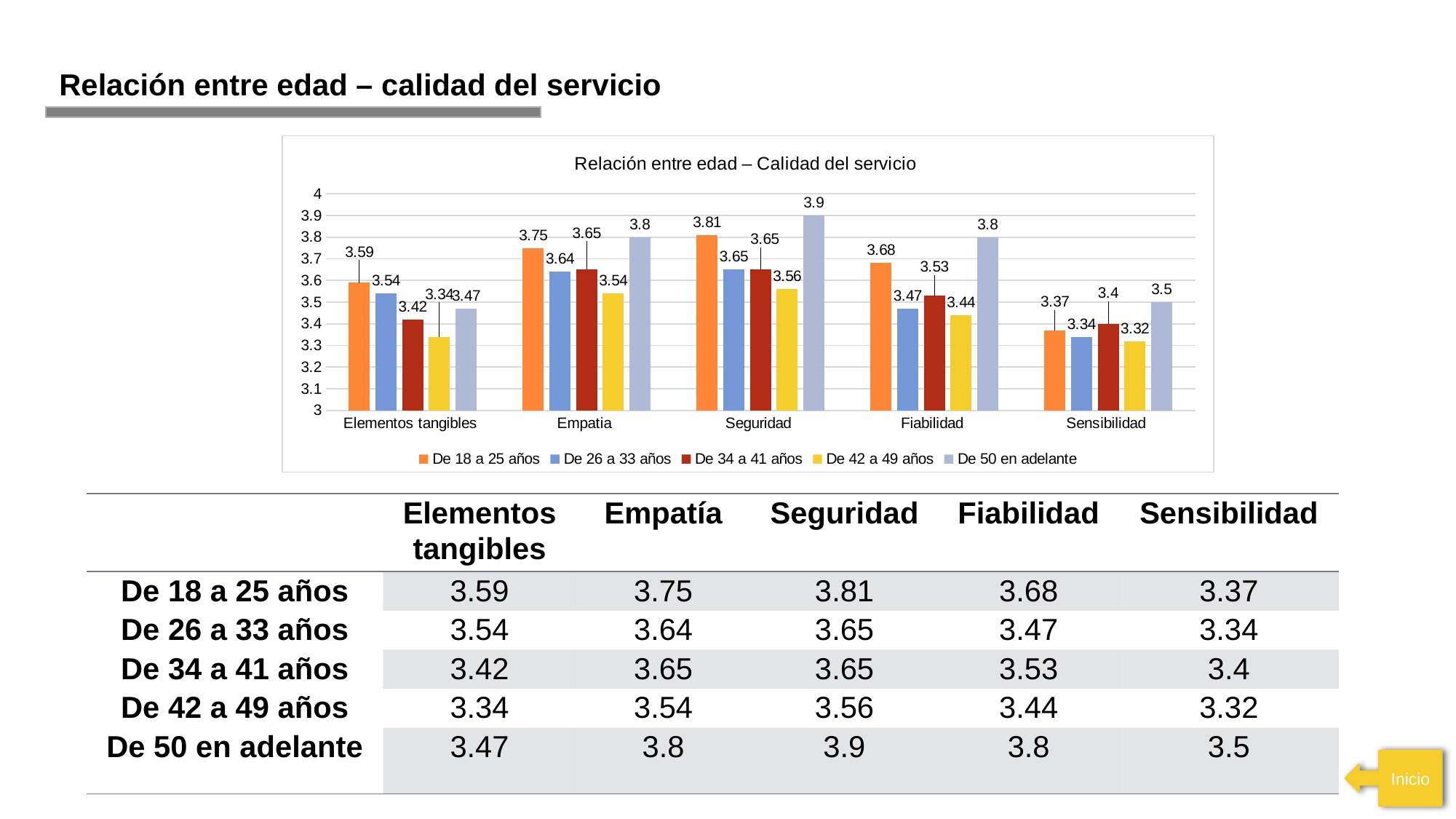
What is the value for 'De 18 a 25 años' in the Seguridad category? 3.81 What kind of chart is shown on the slide? Bar chart What is the title of the chart? Relación entre edad – Calidad del servicio Which category has the highest value for the 'De 50 en adelante' series? Seguridad What is the value for 'De 42 a 49 años' in the Sensibilidad category? 3.32 In the Elementos tangibles category, which is larger: 'De 18 a 25 años' or 'De 26 a 33 años'? De 18 a 25 años Which category has the lowest value for the 'De 18 a 25 años' series? Sensibilidad How many categories are shown on the x axis of the chart? 5 How many series does the chart legend list? 5 Is the value for 'De 34 a 41 años' in the Seguridad category greater or less than 3.5? greater What is the value for 'De 50 en adelante' in the Empatia category? 3.8 What is the difference between the 'De 50 en adelante' and 'De 42 a 49 años' values in the Fiabilidad category? 0.36